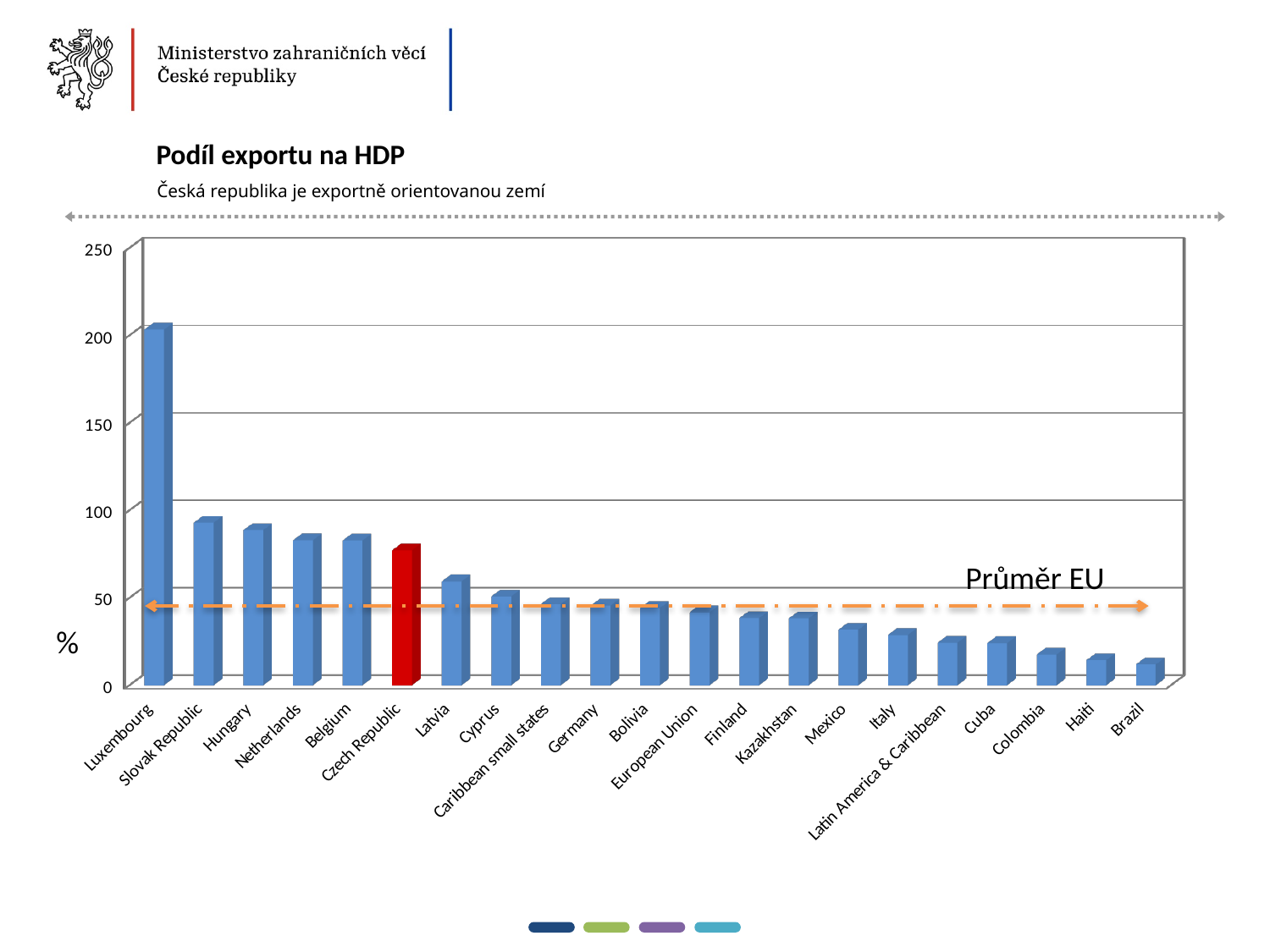
Is the value for Czech Republic greater or less than 50? greater How many countries or regions are plotted on the chart? 21 What is the title of the chart? Podíl exportu na HDP Which country has the lowest export share of GDP on the chart? Brazil What kind of chart is shown on the slide? bar chart Which has a larger value, Czech Republic or Latvia? Czech Republic Is the value for Luxembourg greater or less than 150? greater Which country has the highest export share of GDP on the chart? Luxembourg Is the value for Slovak Republic greater or less than 100? less Do the bar values rise or fall from left to right along the x axis? fall Which country's bar is coloured red? Czech Republic